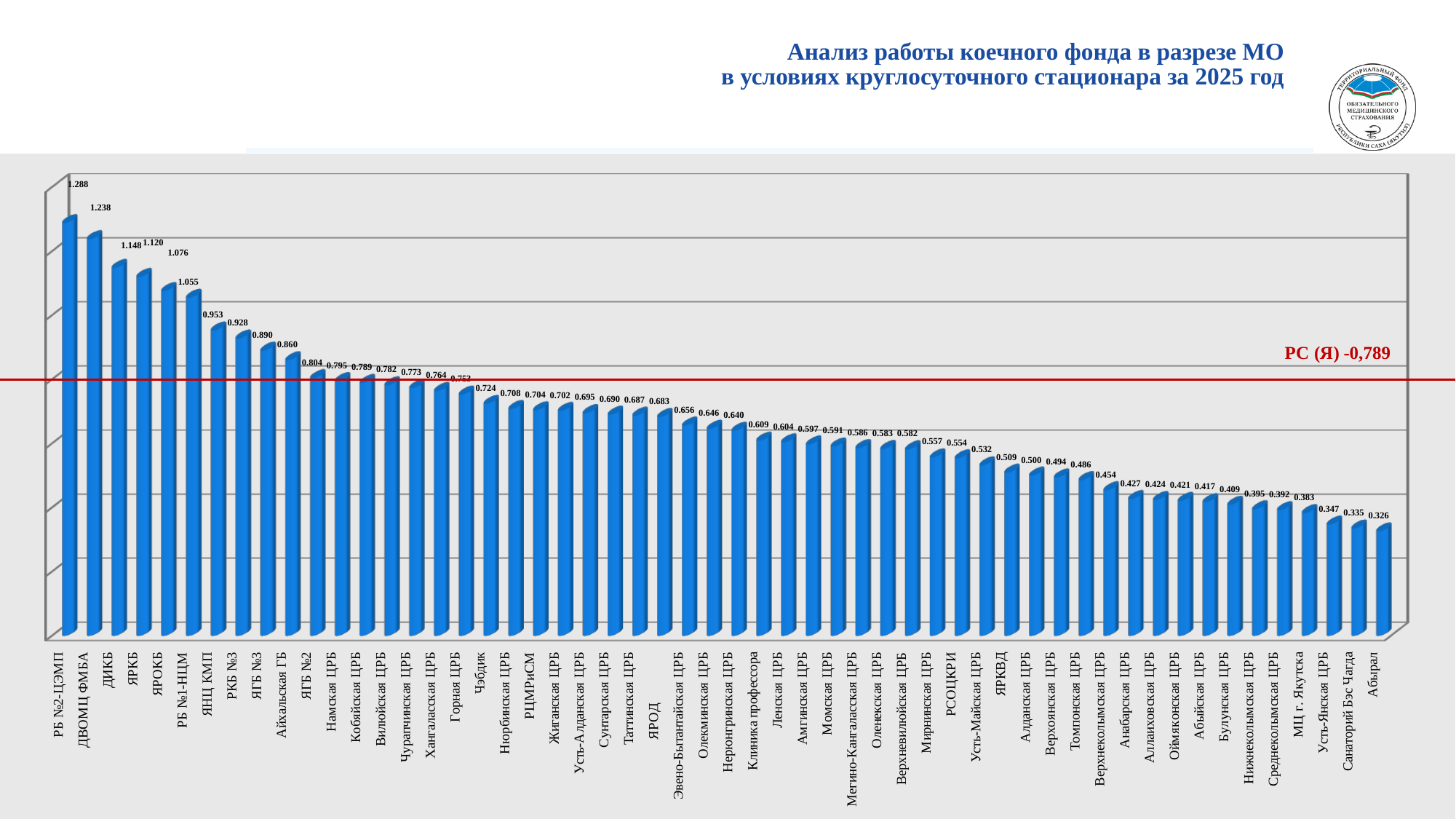
What is the value for Абырал? 0.326 What is the value for РБ №2-ЦЭМП? 1.288 What is the value for Мирнинская ЦРБ? 0.557 Which category has the lowest value? Абырал Do the values rise or fall from left to right along the x axis? fall Which category has the highest value? РБ №2-ЦЭМП Which is larger, the value for ЯГБ №3 or the value for Айхальская ГБ? ЯГБ №3 What kind of chart is shown on the slide? bar chart What value is marked by the red horizontal reference line labelled РС (Я)? 0,789 What is the difference between the highest value (РБ №2-ЦЭМП) and the lowest value (Абырал)? 0.962 What is the value for Намская ЦРБ? 0.795 What is the difference between the values for РБ №2-ЦЭМП and ДВОМЦ ФМБА? 0.050